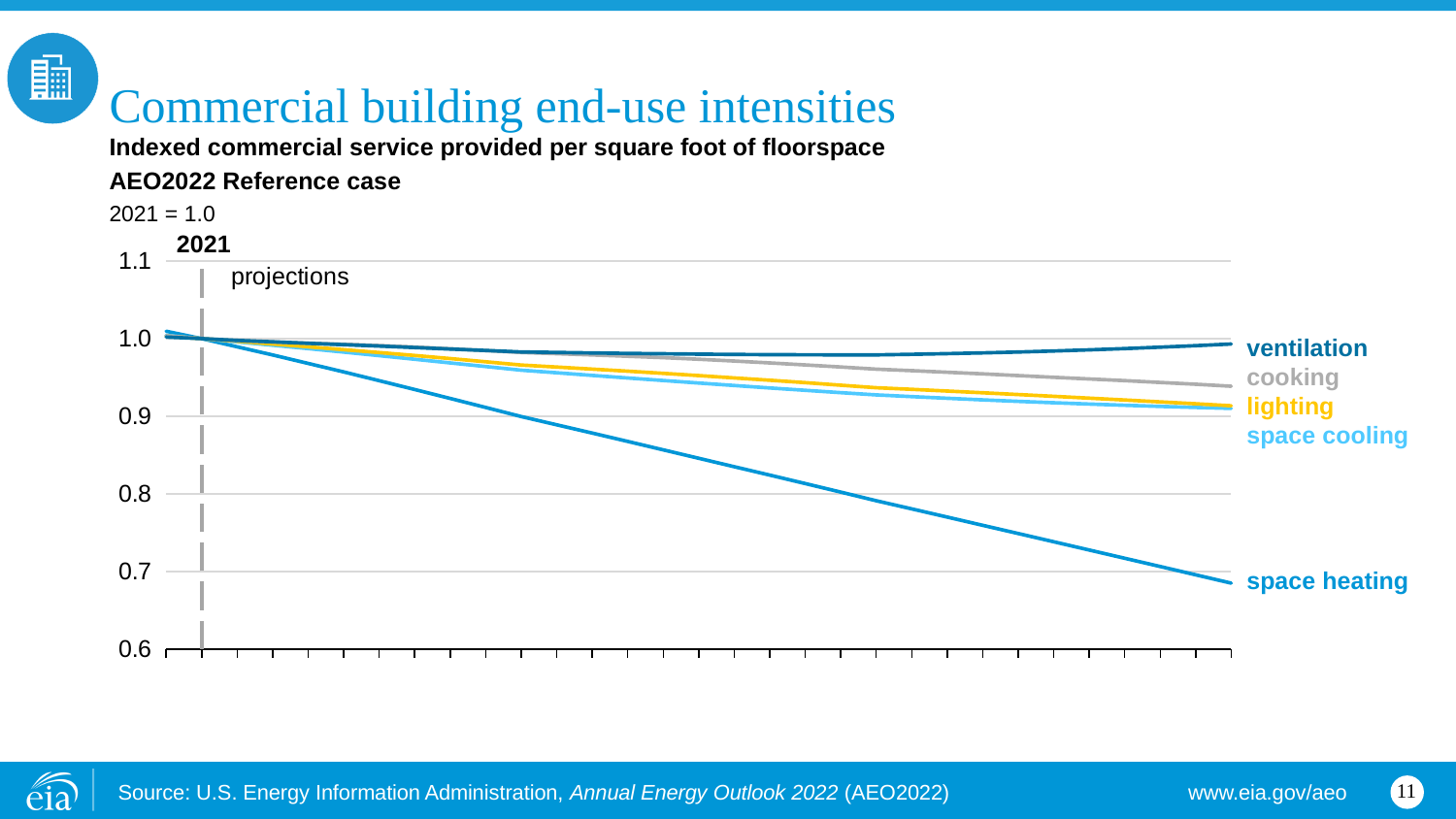
At the end of the projection period, which is larger: cooking or lighting? cooking What is the title of the chart? Commercial building end-use intensities What kind of chart is shown on the slide? line chart Which series has the lowest value at the end of the projection period? space heating Is the value for cooking at the end of the projection period greater or less than 0.9? greater Is the value for space heating at the end of the projection period greater or less than 0.8? less How many series are plotted on the chart? 5 Is the value for ventilation at the end of the projection period greater or less than 0.9? greater What is the indexed value of every series in 2021? 1.0 What year does the dashed vertical line mark as the start of the projections? 2021 Which series has the highest value at the end of the projection period? ventilation Does the space heating series rise or fall over the projection period? fall